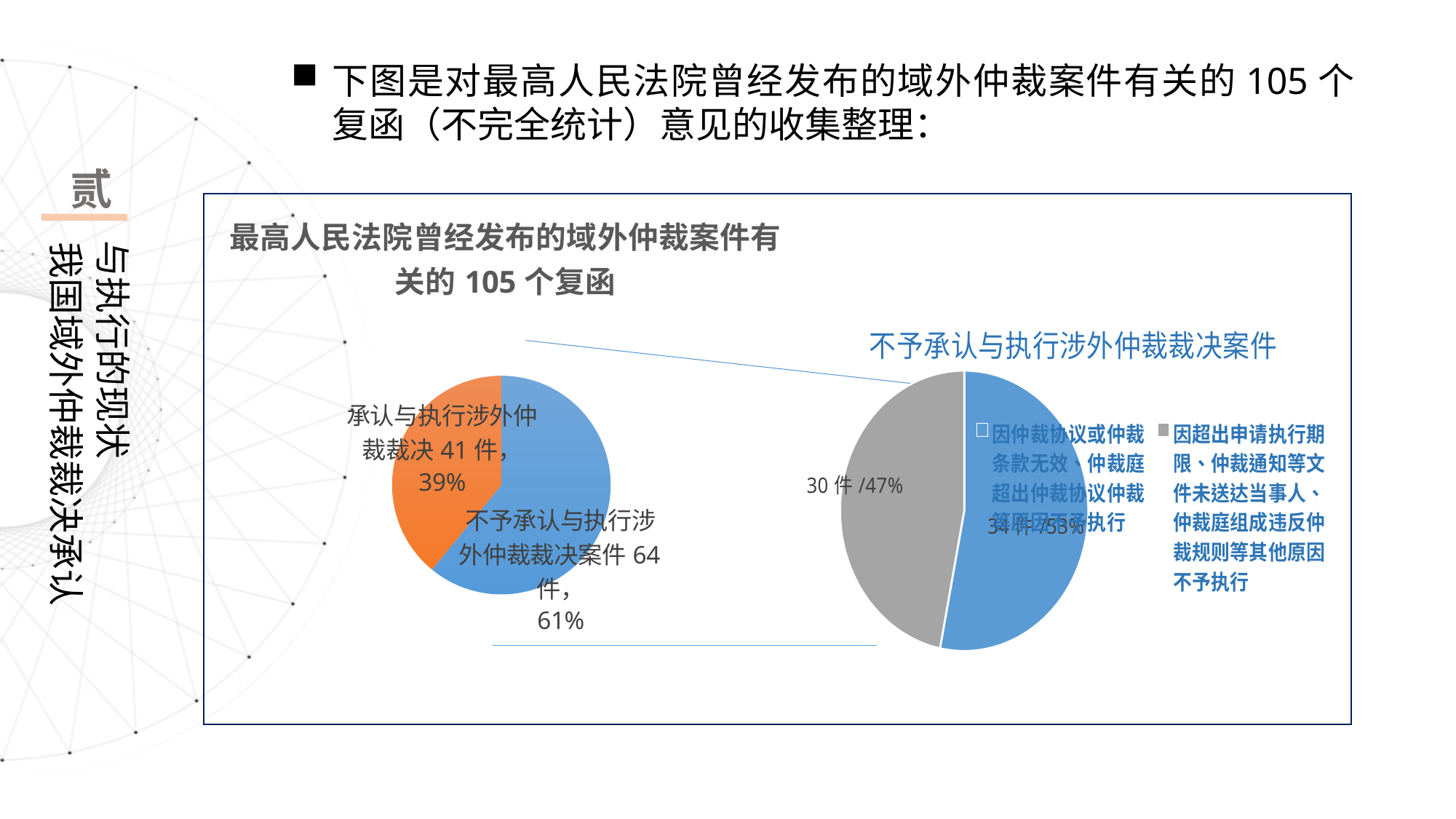
In the right pie chart titled 不予承认与执行涉外仲裁裁决案件, what value is shown on the grey slice? 30 件 /47% In the left pie chart, what percentage share is shown for 不予承认与执行涉外仲裁裁决案件? 61% How many slices does the left pie chart have? 2 In the left pie chart, what is the total number of cases across both slices? 105 件 In the left pie chart, what is the difference in number of cases between 不予承认与执行涉外仲裁裁决案件 and 承认与执行涉外仲裁裁决? 23 件 In the left pie chart titled 最高人民法院曾经发布的域外仲裁案件有关的 105 个复函, how many cases are labelled 承认与执行涉外仲裁裁决? 41 件 In the right pie chart, which slice is larger: the grey slice (30 件) or the blue slice (34 件)? The blue slice (34 件) What type of chart is the chart on the right titled 不予承认与执行涉外仲裁裁决案件? Pie chart In the left pie chart, what percentage share is shown for 承认与执行涉外仲裁裁决? 39% In the right pie chart, what percentage share is shown for the blue slice? 53% In the left pie chart, what colour is the slice for 承认与执行涉外仲裁裁决? Orange In the left pie chart, which slice is larger: 承认与执行涉外仲裁裁决 or 不予承认与执行涉外仲裁裁决案件? 不予承认与执行涉外仲裁裁决案件